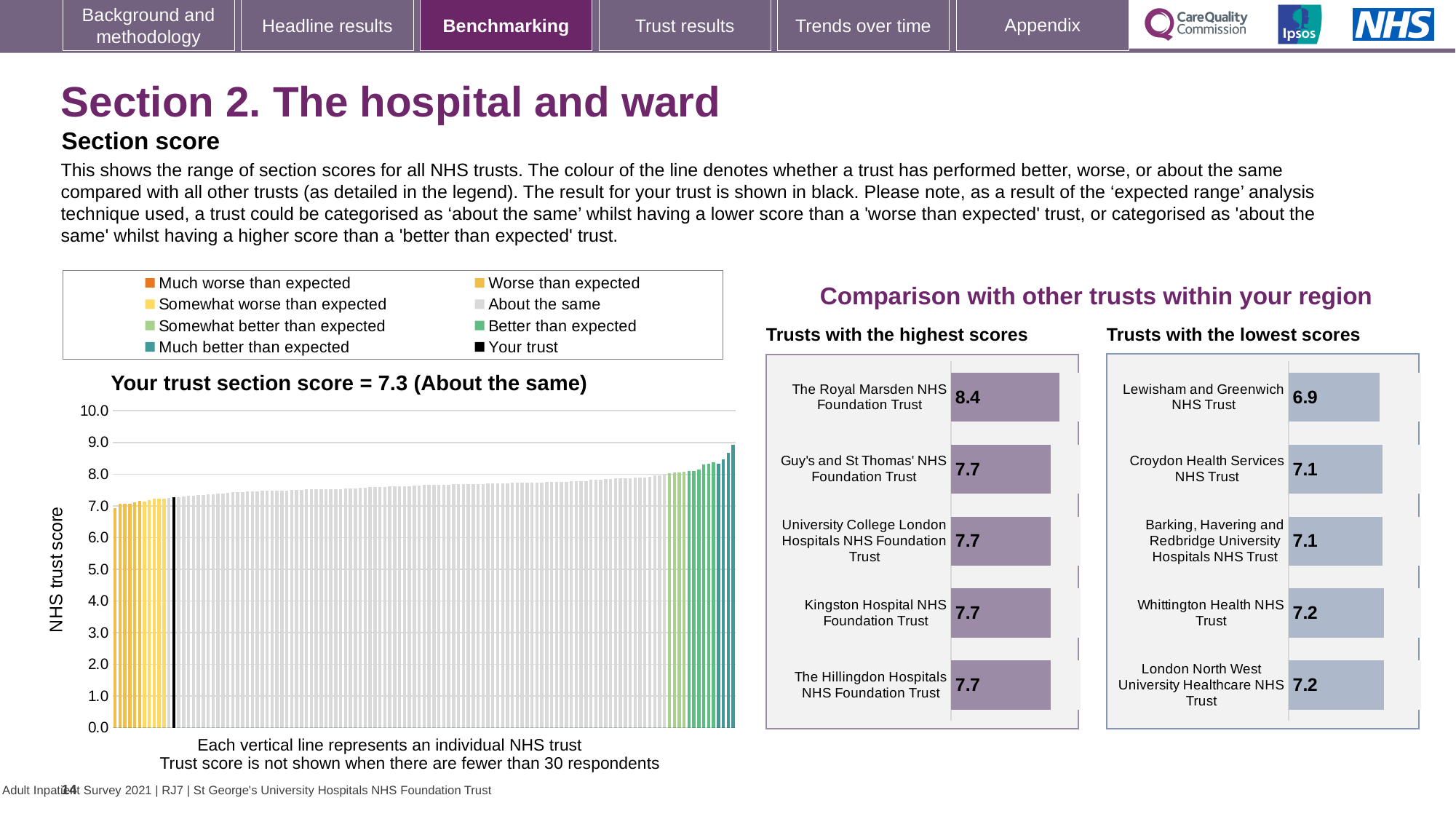
In the 'Trusts with the lowest scores' chart, what is the score for Whittington Health NHS Trust? 7.2 In the 'Trusts with the lowest scores' chart, which trust has the lowest score? Lewisham and Greenwich NHS Trust In the 'Your trust section score' chart, what is the section score for your trust? 7.3 In the 'Your trust section score' chart, do the trust scores rise or fall from left to right along the x axis? rise In the 'Trusts with the highest scores' chart, what is the score for Kingston Hospital NHS Foundation Trust? 7.7 In the 'Trusts with the lowest scores' chart, which has the larger score: Croydon Health Services NHS Trust or Lewisham and Greenwich NHS Trust? Croydon Health Services NHS Trust In the 'Trusts with the highest scores' chart, what is the score for The Royal Marsden NHS Foundation Trust? 8.4 In the 'Trusts with the lowest scores' chart, what is the score for Lewisham and Greenwich NHS Trust? 6.9 In the 'Trusts with the highest scores' chart, what is the difference between the scores of The Royal Marsden NHS Foundation Trust and Guy's and St Thomas' NHS Foundation Trust? 0.7 In the 'Trusts with the lowest scores' chart, what is the difference between the scores of London North West University Healthcare NHS Trust and Lewisham and Greenwich NHS Trust? 0.3 In the 'Trusts with the highest scores' chart, which trust has the highest score? The Royal Marsden NHS Foundation Trust How many trusts are shown in the 'Trusts with the highest scores' chart? 5